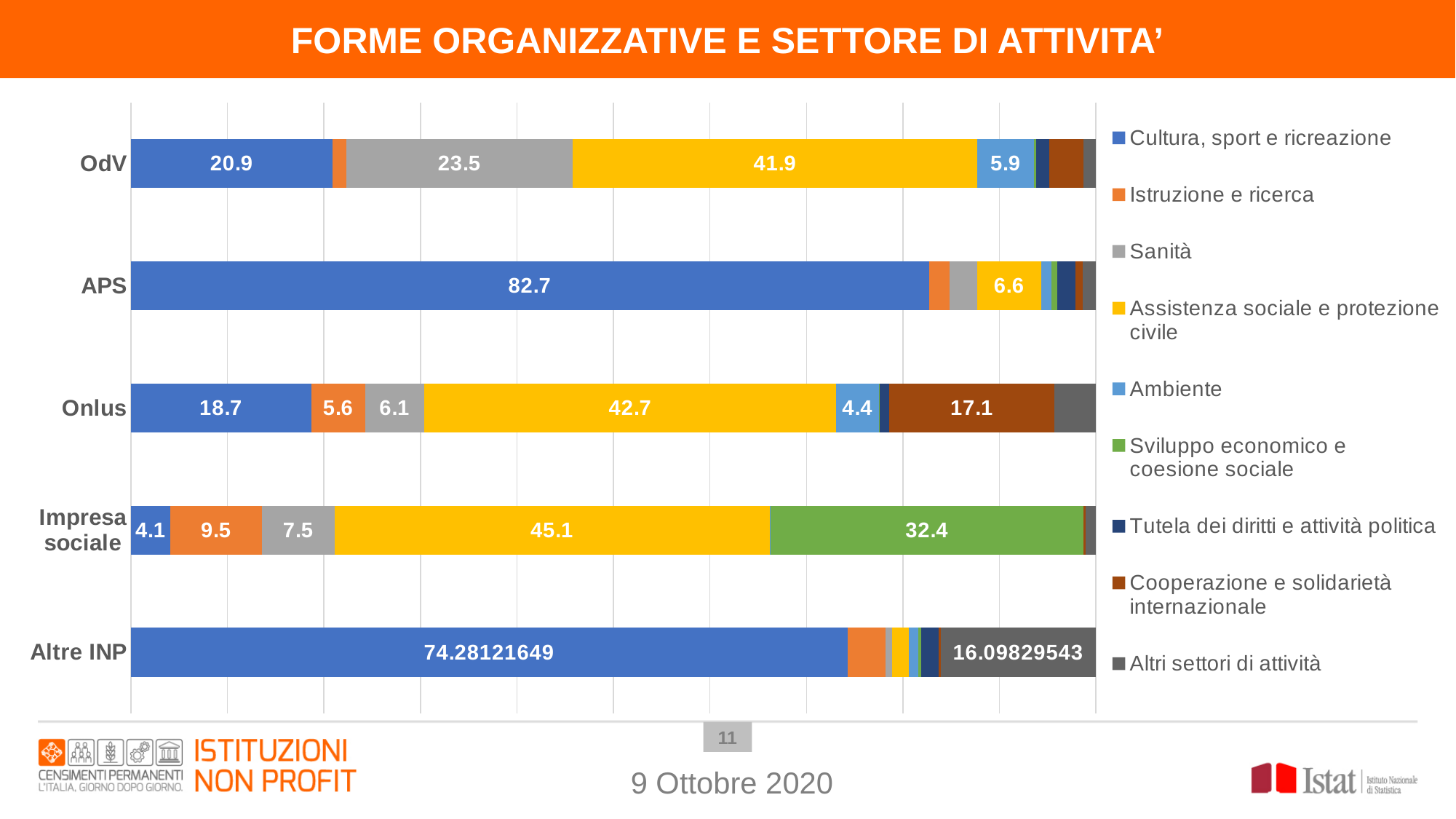
In the OdV bar, which is larger: Sanità or Cultura, sport e ricreazione? Sanità What is the difference between the Assistenza sociale e protezione civile values for Onlus and OdV? 0.8 What is the value for Assistenza sociale e protezione civile in the Onlus bar? 42.7 Which organizational form has the lowest labelled value for Cultura, sport e ricreazione? Impresa sociale What is the value for Cooperazione e solidarietà internazionale in the Onlus bar? 17.1 What is the value for Sviluppo economico e coesione sociale in the Impresa sociale bar? 32.4 How many organizational forms are shown on the vertical axis? 5 How many series does the legend list? 9 What is the value for Cultura, sport e ricreazione in the APS bar? 82.7 What is the value for Altri settori di attività in the Altre INP bar? 16.09829543 Which organizational form has the highest value for Cultura, sport e ricreazione? APS What kind of chart is shown on the slide? Stacked bar chart